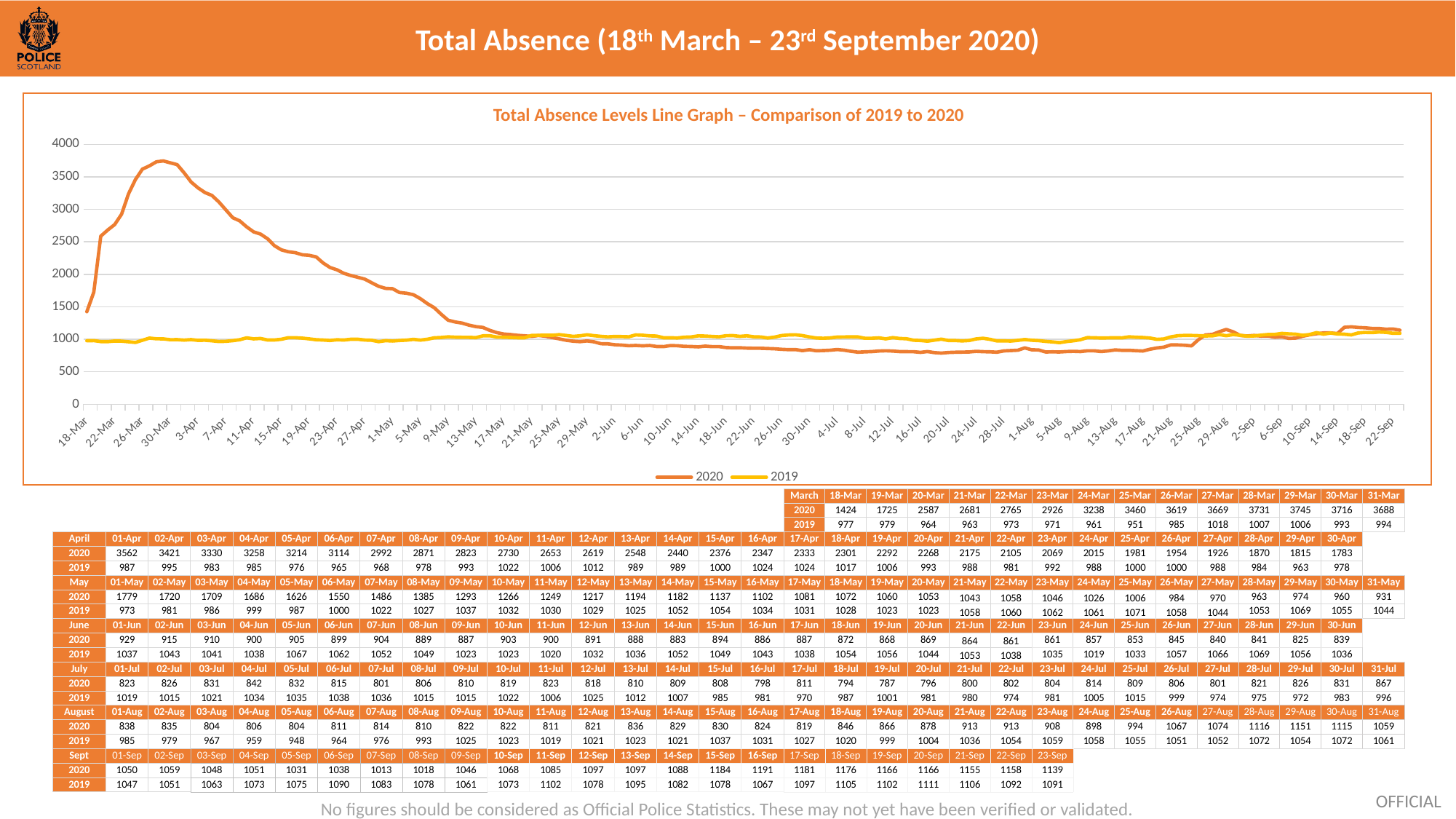
On which date does the 2020 series reach its highest value? 29-Mar Is the 2020 value on 30-Mar greater or less than 3500? greater What is the title of the chart? Total Absence Levels Line Graph – Comparison of 2019 to 2020 What kind of chart is shown on the slide? line chart What is the 2020 total absence value on 18-Mar? 1424 What is the 2019 total absence value on 23-Sep? 1091 Does the 2020 series rise or fall from 30-Mar through the end of April? fall How many series does the chart legend list? 2 On 01-Jul, which series has the higher value, 2020 or 2019? 2019 What is the 2019 total absence value on 18-Mar? 977 What is the 2020 total absence value on 23-Sep? 1139 What is the difference between the 2020 and 2019 values on 18-Mar? 447